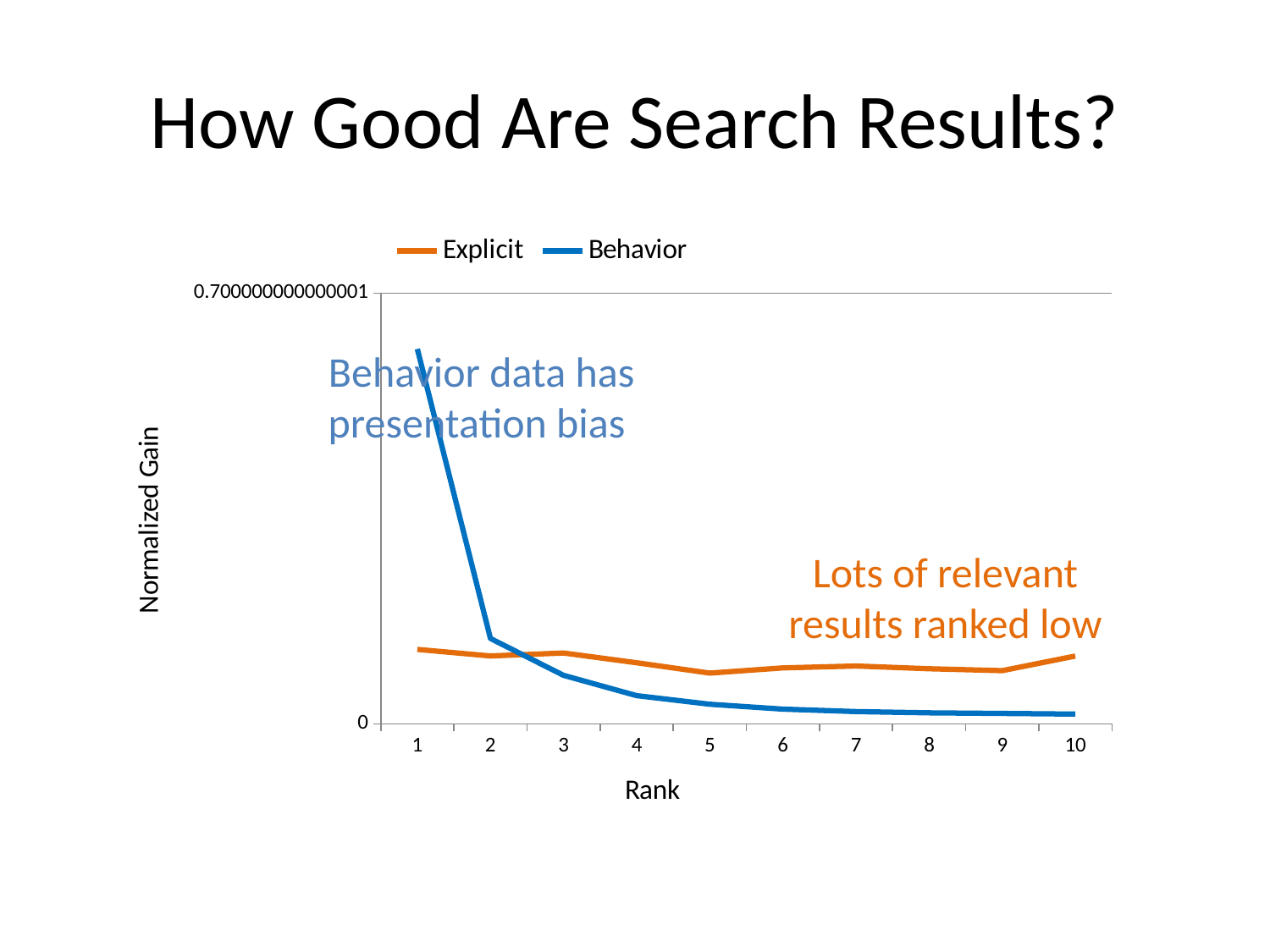
How many rank positions are plotted along the x axis? 10 At rank 1, which series has the larger value, Explicit or Behavior? Behavior What is the label of the y axis? Normalized Gain Does the Behavior series rise or fall as rank increases from 1 to 10? Fall What is the label of the x axis? Rank At rank 5, which series has the larger value, Explicit or Behavior? Explicit At rank 10, which series has the larger value, Explicit or Behavior? Explicit What kind of chart is shown on the slide? Line chart How many series does the legend list? 2 At which rank does the Behavior series reach its highest value? 1